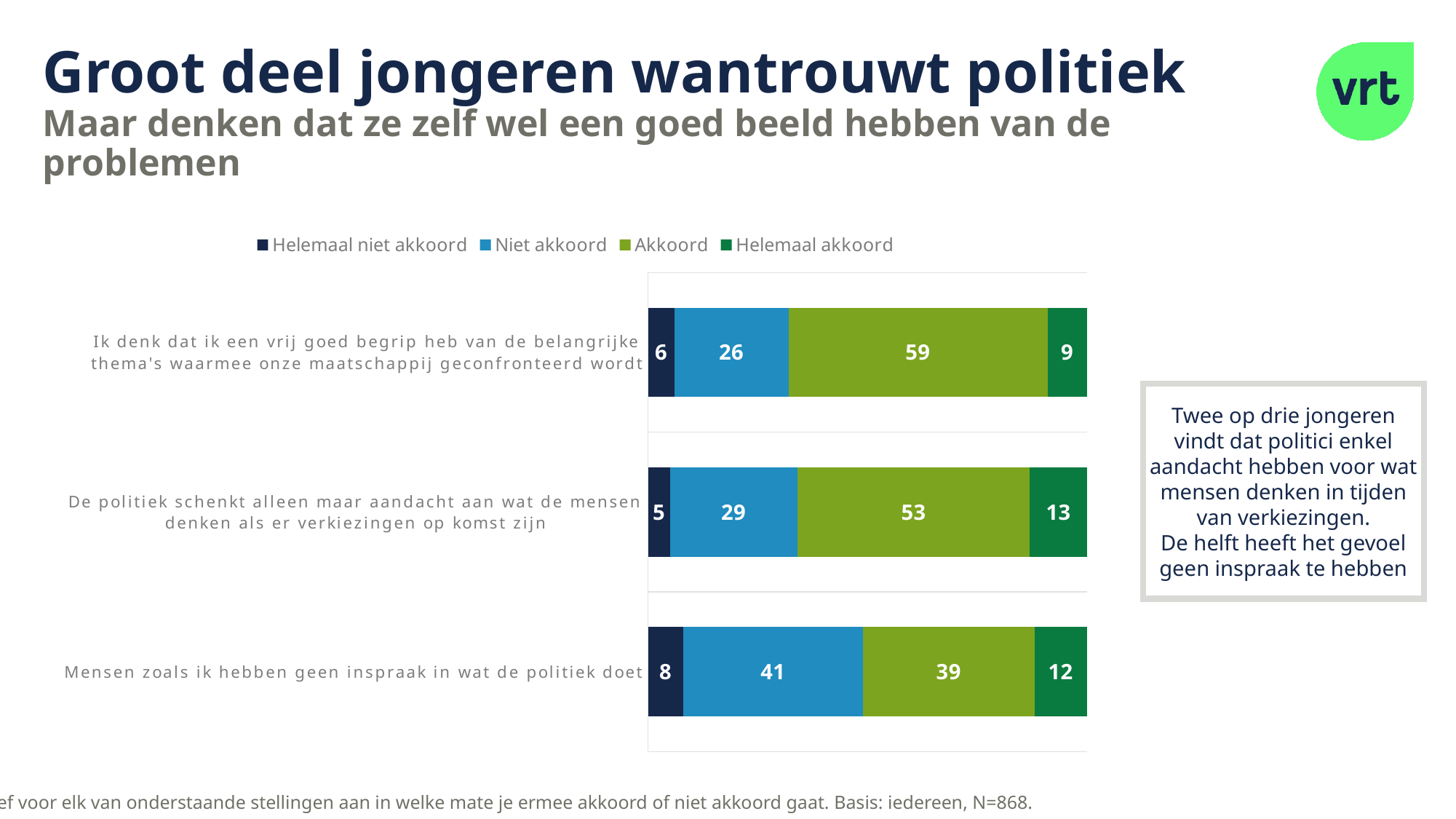
What kind of chart is shown on the slide? Stacked bar chart What is the difference between the "Akkoord" values for "Ik denk dat ik een vrij goed begrip heb..." and "De politiek schenkt alleen maar aandacht..."? 6 How many series does the legend list? 4 For the statement "Mensen zoals ik hebben geen inspraak in wat de politiek doet", which is larger: "Niet akkoord" or "Akkoord"? Niet akkoord Which legend entry is shown in dark navy blue? Helemaal niet akkoord What is the total of the stacked bar for "De politiek schenkt alleen maar aandacht aan wat de mensen denken als er verkiezingen op komst zijn"? 100 What is the value for "Helemaal akkoord" on the statement "De politiek schenkt alleen maar aandacht aan wat de mensen denken als er verkiezingen op komst zijn"? 13 How many statements (categories) are shown in the chart? 3 What is the value for "Niet akkoord" on the statement "Mensen zoals ik hebben geen inspraak in wat de politiek doet"? 41 Which statement has the lowest value for "Akkoord"? Mensen zoals ik hebben geen inspraak in wat de politiek doet Which statement has the highest value for "Helemaal niet akkoord"? Mensen zoals ik hebben geen inspraak in wat de politiek doet What is the value for "Akkoord" on the statement "Ik denk dat ik een vrij goed begrip heb van de belangrijke thema's waarmee onze maatschappij geconfronteerd wordt"? 59